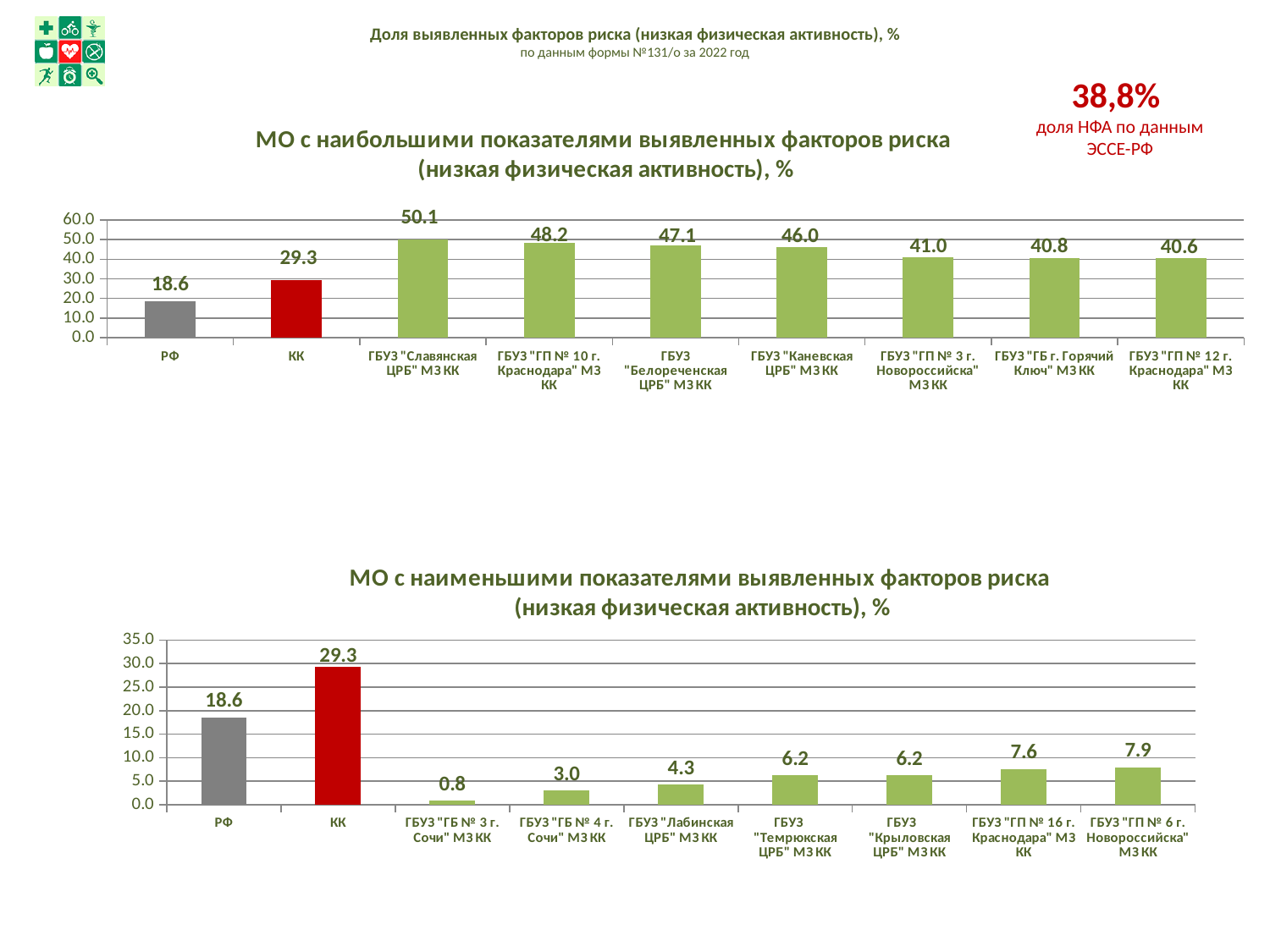
In the bottom chart (МО с наименьшими показателями), which category has the lowest value? ГБУЗ "ГБ № 3 г. Сочи" МЗ КК In the top chart (МО с наибольшими показателями), what is the difference between the values for ГБУЗ "Славянская ЦРБ" МЗ КК and КК? 20.8 In the bottom chart (МО с наименьшими показателями), what is the value for ГБУЗ "ГБ № 3 г. Сочи" МЗ КК? 0.8 In the bottom chart (МО с наименьшими показателями), which is larger: the value for ГБУЗ "Лабинская ЦРБ" МЗ КК or the value for ГБУЗ "ГБ № 4 г. Сочи" МЗ КК? ГБУЗ "Лабинская ЦРБ" МЗ КК What type of chart is the top chart (МО с наибольшими показателями)? Bar chart In the top chart (МО с наибольшими показателями), what is the value for ГБУЗ "Каневская ЦРБ" МЗ КК? 46.0 In the top chart (МО с наибольшими показателями), how many categories are shown on the x axis? 9 In the top chart (МО с наибольшими показателями), which category has the highest value? ГБУЗ "Славянская ЦРБ" МЗ КК In the top chart (МО с наибольшими показателями), what colour is the bar for КК? Red In the bottom chart (МО с наименьшими показателями), what is the value for ГБУЗ "ГП № 6 г. Новороссийска" МЗ КК? 7.9 In the bottom chart (МО с наименьшими показателями), what is the difference between the values for КК and РФ? 10.7 In the top chart (МО с наибольшими показателями), what is the value for ГБУЗ "Славянская ЦРБ" МЗ КК? 50.1